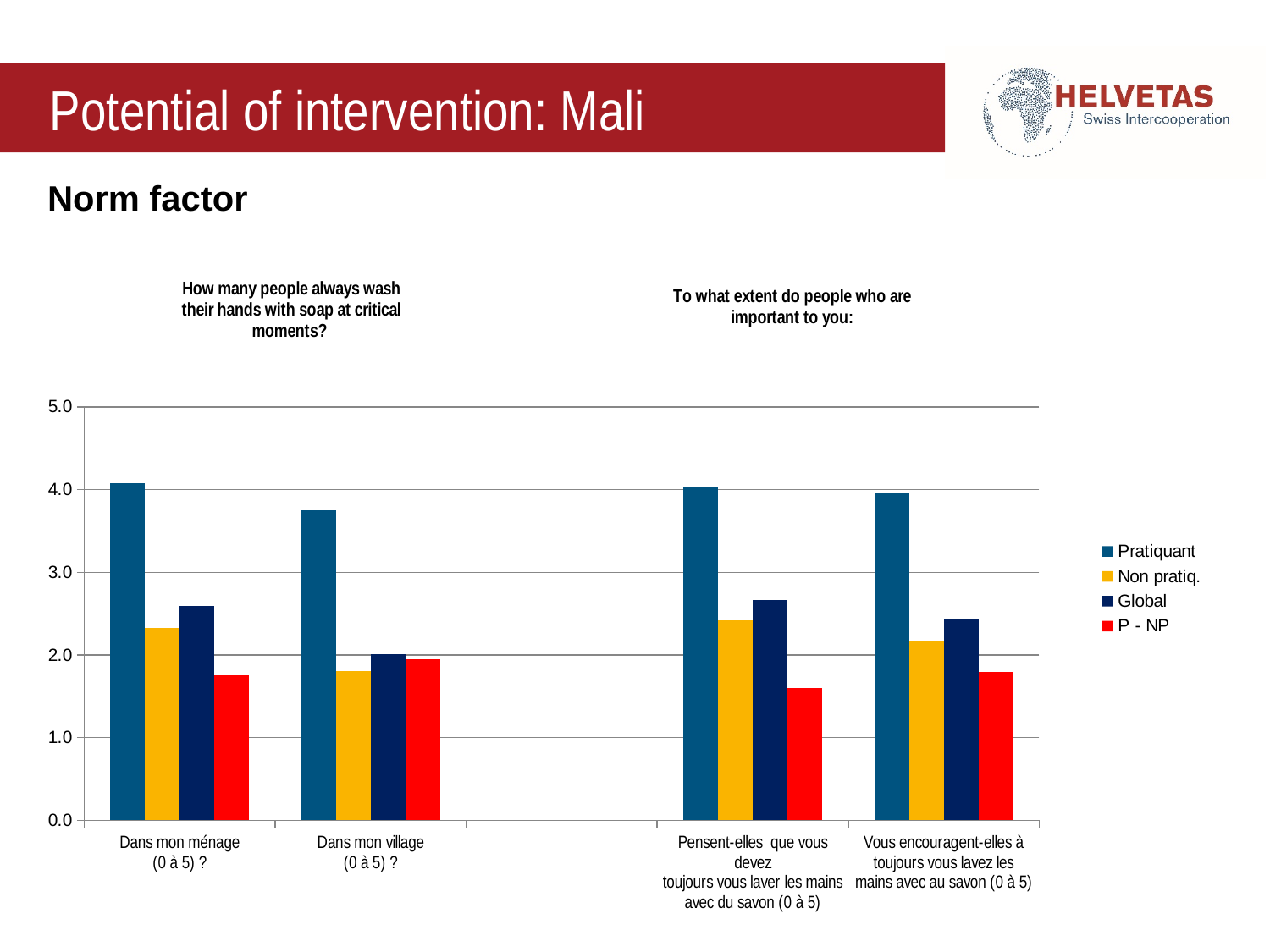
Is the Pratiquant value for 'Dans mon village (0 à 5) ?' greater or less than 4.0? less Which series has the highest value for 'Dans mon ménage (0 à 5) ?'? Pratiquant What kind of chart is shown on the slide? bar chart Which is larger for 'Vous encouragent-elles à toujours vous lavez les mains avec au savon (0 à 5)': the Pratiquant value or the Non pratiq. value? Pratiquant How many series does the legend list? 4 What are the four entries listed in the chart legend? Pratiquant, Non pratiq., Global, P - NP For which category is the Pratiquant value lowest? Dans mon village (0 à 5) ? Is the Global value for 'Pensent-elles que vous devez toujours vous laver les mains avec du savon (0 à 5)' greater or less than 2.0? greater Which series has the lowest value for 'Dans mon ménage (0 à 5) ?'? P - NP Which is larger for 'Pensent-elles que vous devez toujours vous laver les mains avec du savon (0 à 5)': the Global value or the P - NP value? Global Is the P - NP value for 'Pensent-elles que vous devez toujours vous laver les mains avec du savon (0 à 5)' greater or less than 2.0? less How many categories are shown on the x axis? 4